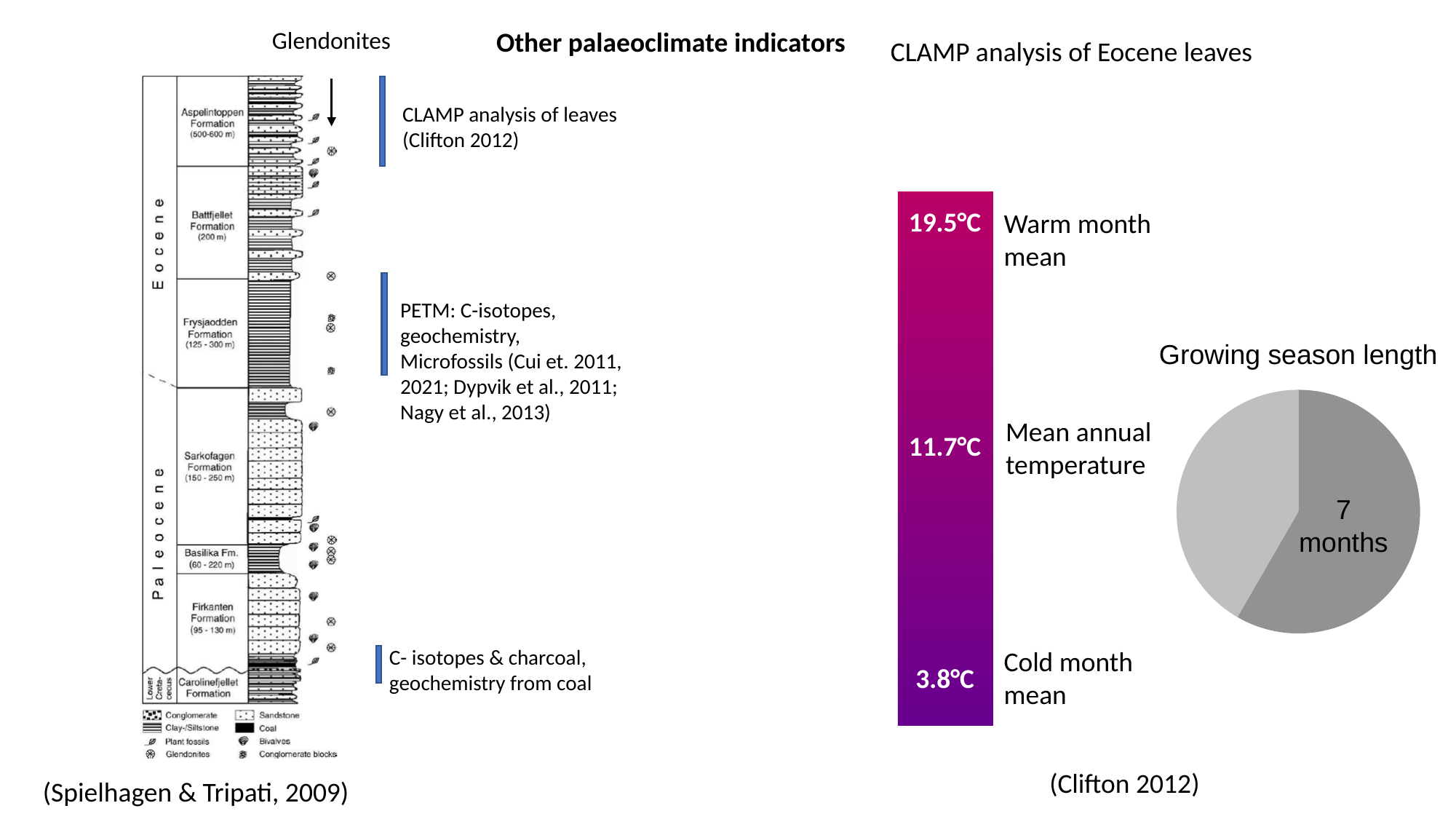
In the CLAMP analysis temperature bar, what is the warm month mean? 19.5°C How many slices does the "Growing season length" pie chart have? 2 In the CLAMP analysis temperature bar, which value is the lowest? Cold month mean (3.8°C) In the "Growing season length" pie chart, what label is printed on the dark grey slice? 7 months In the "Growing season length" pie chart, which slice is larger, the dark grey "7 months" slice or the light grey slice? the dark grey "7 months" slice What kind of chart is the "Growing season length" chart? pie chart In the CLAMP analysis temperature bar, what is the difference between the warm month mean and the cold month mean? 15.7°C In the CLAMP analysis temperature bar, which value is the highest? Warm month mean (19.5°C) What is the title of the pie chart on the right of the slide? Growing season length In the CLAMP analysis temperature bar, what is the difference between the warm month mean and the mean annual temperature? 7.8°C In the CLAMP analysis temperature bar, what is the mean annual temperature? 11.7°C In the CLAMP analysis temperature bar, what is the cold month mean? 3.8°C